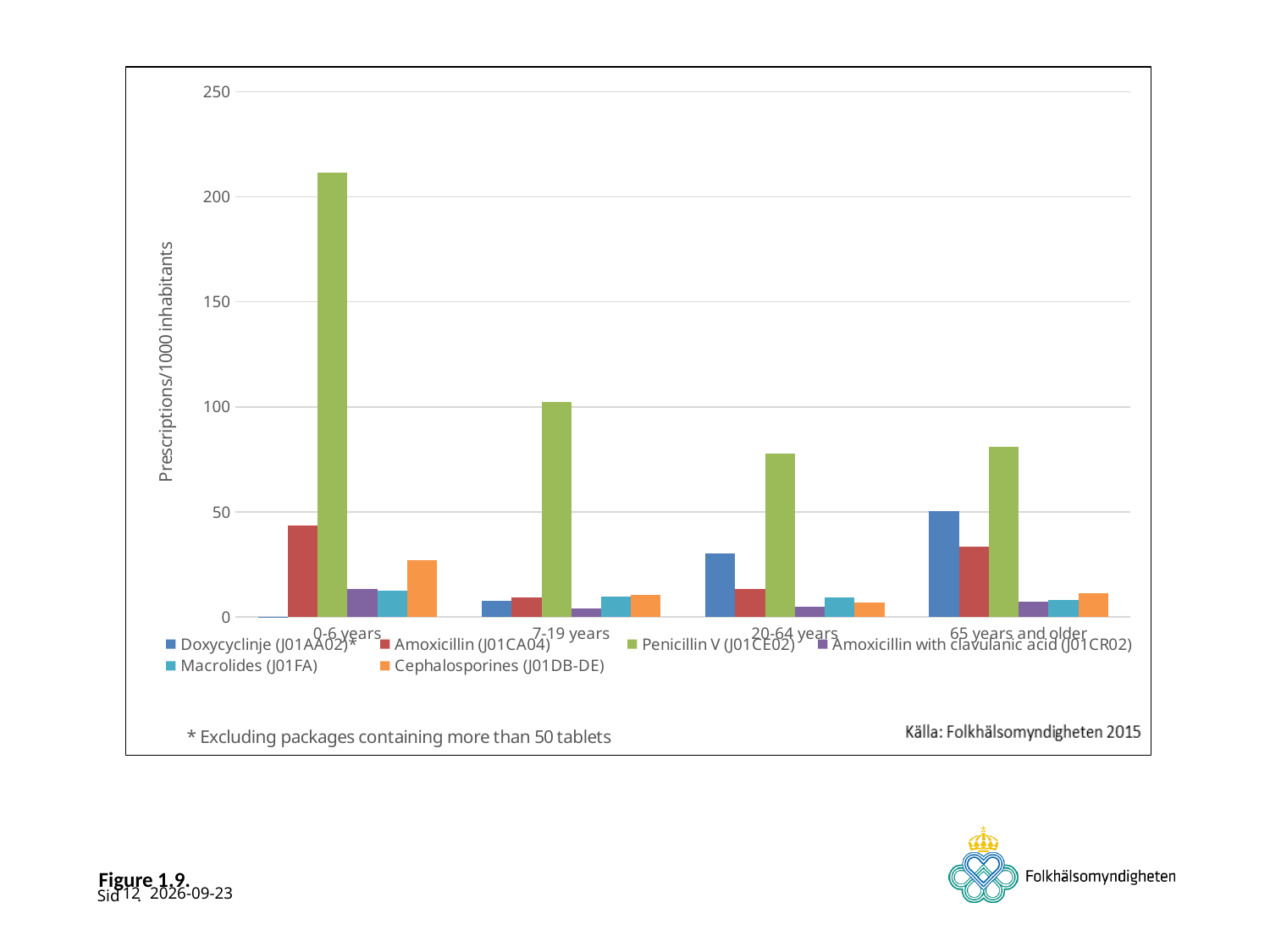
Is the value for Penicillin V (J01CE02) in the 0-6 years group greater or less than 200? greater Which series has the highest value in the 65 years and older group? Penicillin V (J01CE02) Do the values for Doxycycline (J01AA02)* rise or fall across the age groups from 0-6 years to 65 years and older? rise Is the value for Amoxicillin (J01CA04) in the 0-6 years group greater or less than 50? less What kind of chart is shown on the slide? bar chart How many series does the legend list? 6 How many age groups are shown on the x axis? 4 Is the value for Penicillin V (J01CE02) in the 7-19 years group greater or less than 150? less Which is larger: Doxycycline (J01AA02)* for 65 years and older or for 20-64 years? 65 years and older What is the label on the y axis? Prescriptions/1000 inhabitants Which age group has the highest value for Penicillin V (J01CE02)? 0-6 years